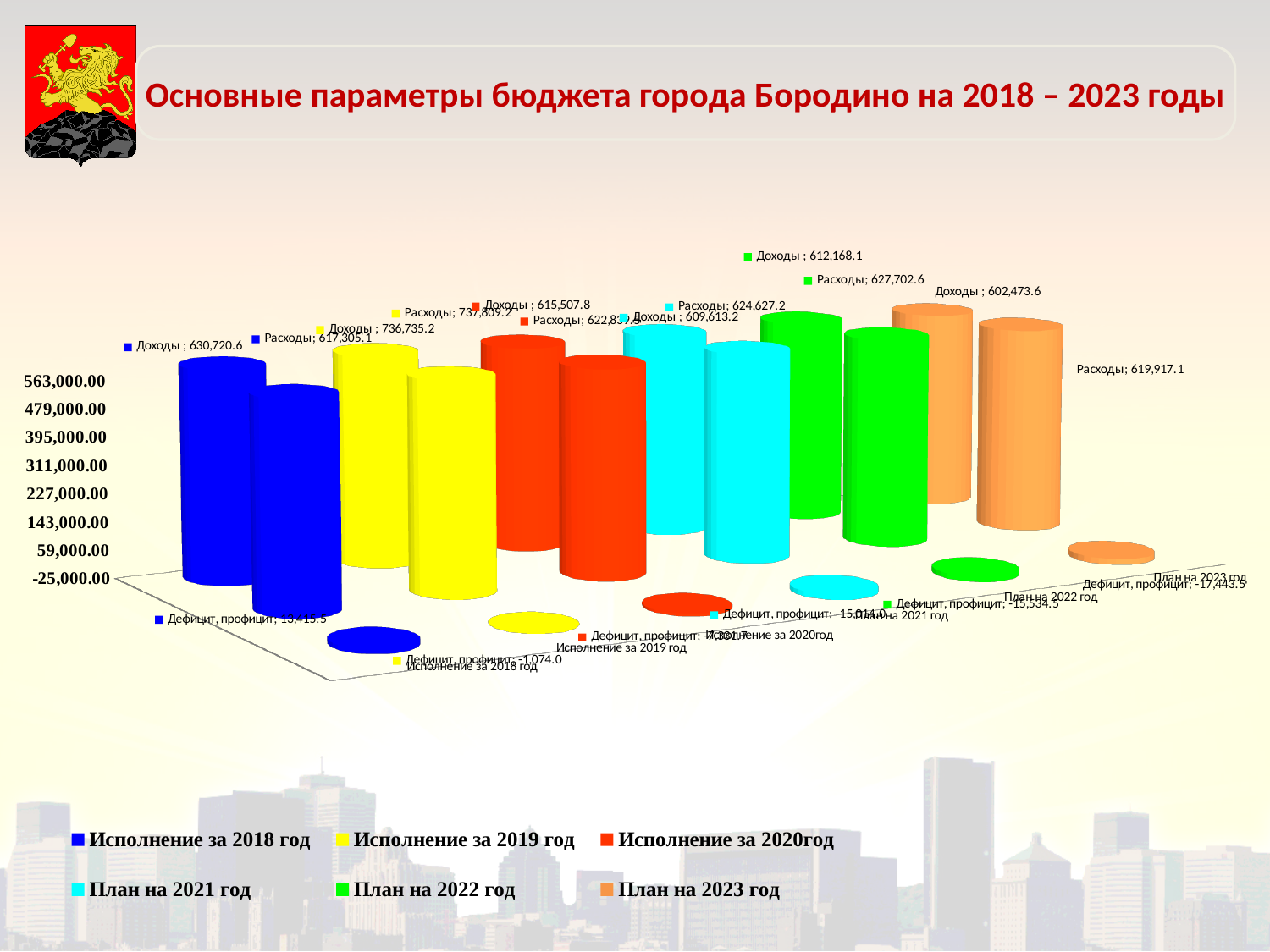
Which series has the lowest value for Доходы? План на 2023 год What is the value of Доходы for План на 2023 год? 602,473.6 What is the difference between Расходы and Доходы for План на 2021 год? 15,014.0 What is the title of the slide? Основные параметры бюджета города Бородино на 2018 – 2023 годы For Исполнение за 2018 год, which is larger: Доходы or Расходы? Доходы Which series has the highest value for Доходы? Исполнение за 2019 год What is the value of Дефицит, профицит for План на 2022 год? -15,534.5 What is the value of Расходы for План на 2022 год? 627,702.6 What is the value of Доходы for Исполнение за 2018 год? 630,720.6 What kind of chart is shown on the slide? Bar chart How many series does the legend list? 6 What is the value of Расходы for Исполнение за 2019 год? 737,809.2